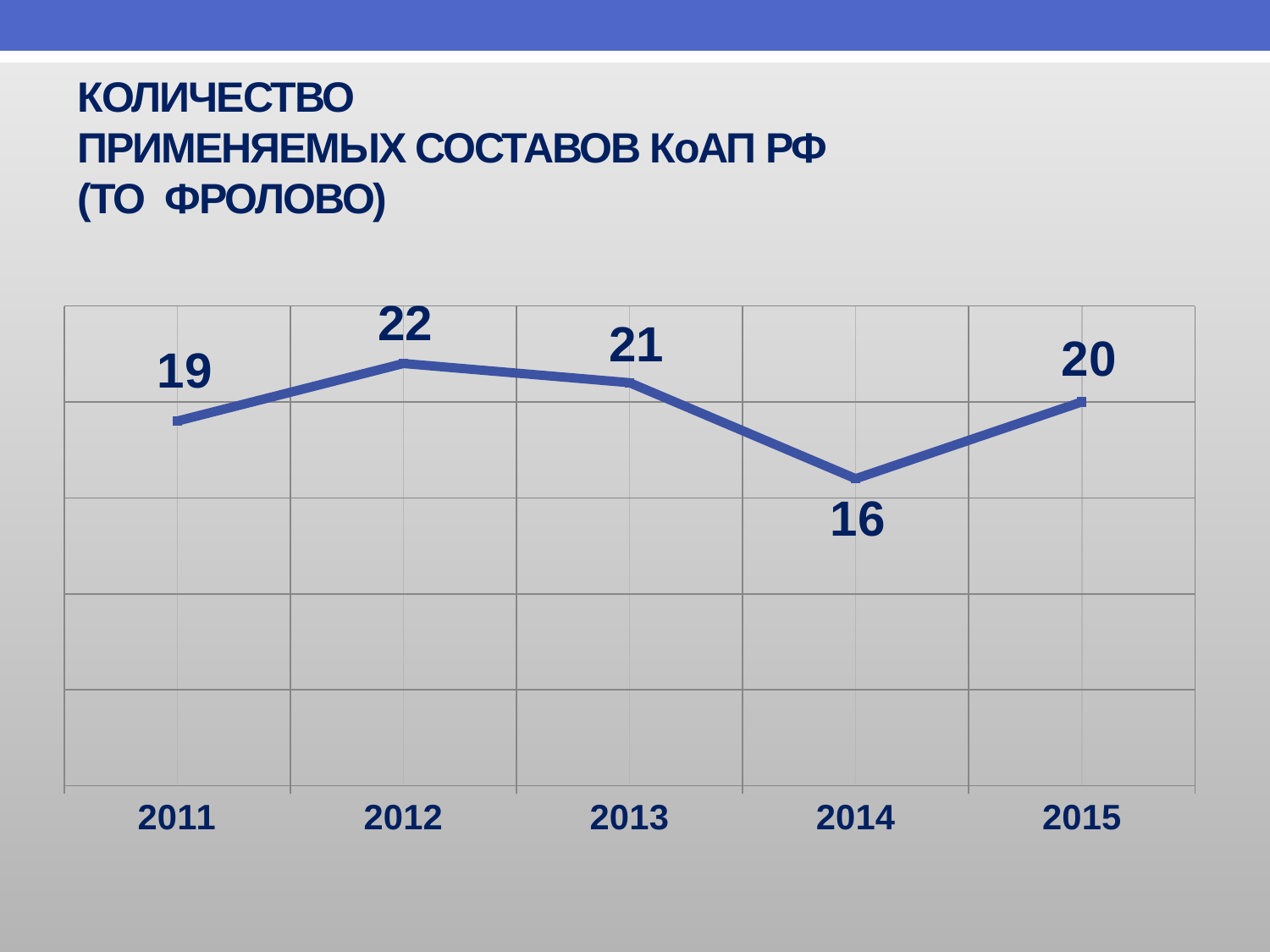
Which year has the highest value? 2012 Which is larger, the value for 2011 or the value for 2013? 2013 What is the value for 2011? 19 What is the difference between the values for 2013 and 2015? 1 What is the value for 2014? 16 How many years are plotted on the chart? 5 What is the title of the chart? КОЛИЧЕСТВО ПРИМЕНЯЕМЫХ СОСТАВОВ КоАП РФ (ТО ФРОЛОВО) Which year has the lowest value? 2014 What is the value for 2015? 20 What is the difference between the values for 2012 and 2014? 6 What kind of chart is shown on the slide? line chart Does the value rise or fall from 2013 to 2014? fall